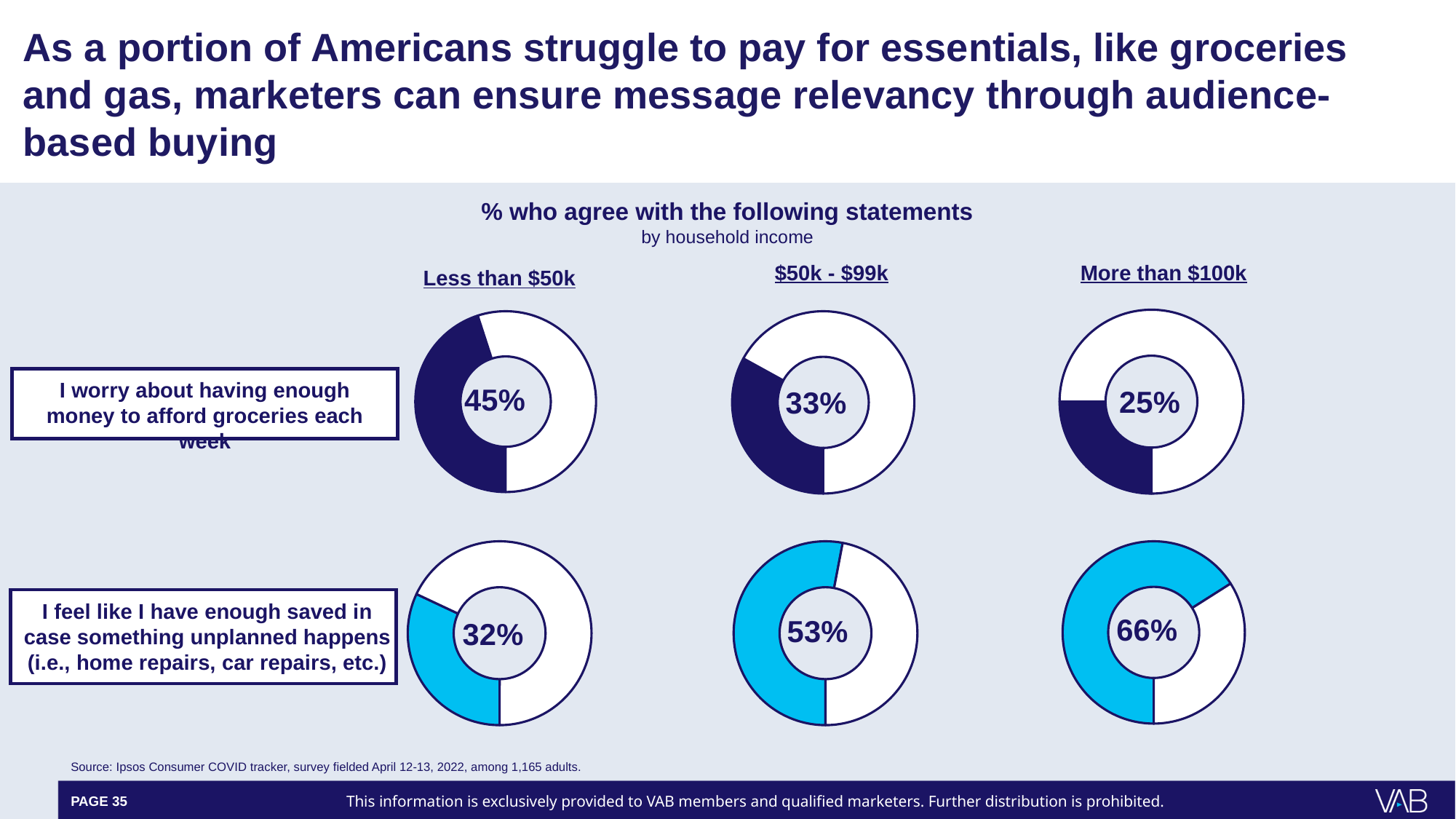
In the 'I worry about having enough money to afford groceries each week' row, what percentage agree among those with household income less than $50k? 45% In the 'I feel like I have enough saved in case something unplanned happens' row, which income group has the lowest percentage agreeing? Less than $50k In the 'I feel like I have enough saved in case something unplanned happens' row, what percentage agree among those with household income less than $50k? 32% In the 'I worry about having enough money to afford groceries each week' row, which income group has the highest percentage agreeing? Less than $50k In the 'I worry about having enough money to afford groceries each week' row, what is the difference in percentage points between the less than $50k group and the more than $100k group? 20 percentage points Across the income groups from left to right, does the percentage who feel they have enough saved rise or fall? Rise In the 'I feel like I have enough saved in case something unplanned happens' row, what percentage agree among those with household income more than $100k? 66% In the 'I feel like I have enough saved in case something unplanned happens' row, what is the difference in percentage points between the more than $100k group and the $50k - $99k group? 13 percentage points In the 'I worry about having enough money to afford groceries each week' row, what percentage agree among those with household income more than $100k? 25% In the 'I worry about having enough money to afford groceries each week' row, what percentage agree among those with household income of $50k - $99k? 33% What type of chart is used to show the percentages on this slide? Donut (pie) chart For the $50k - $99k income group, which is larger: the percentage who worry about affording groceries or the percentage who feel they have enough saved? The percentage who feel they have enough saved (53%)